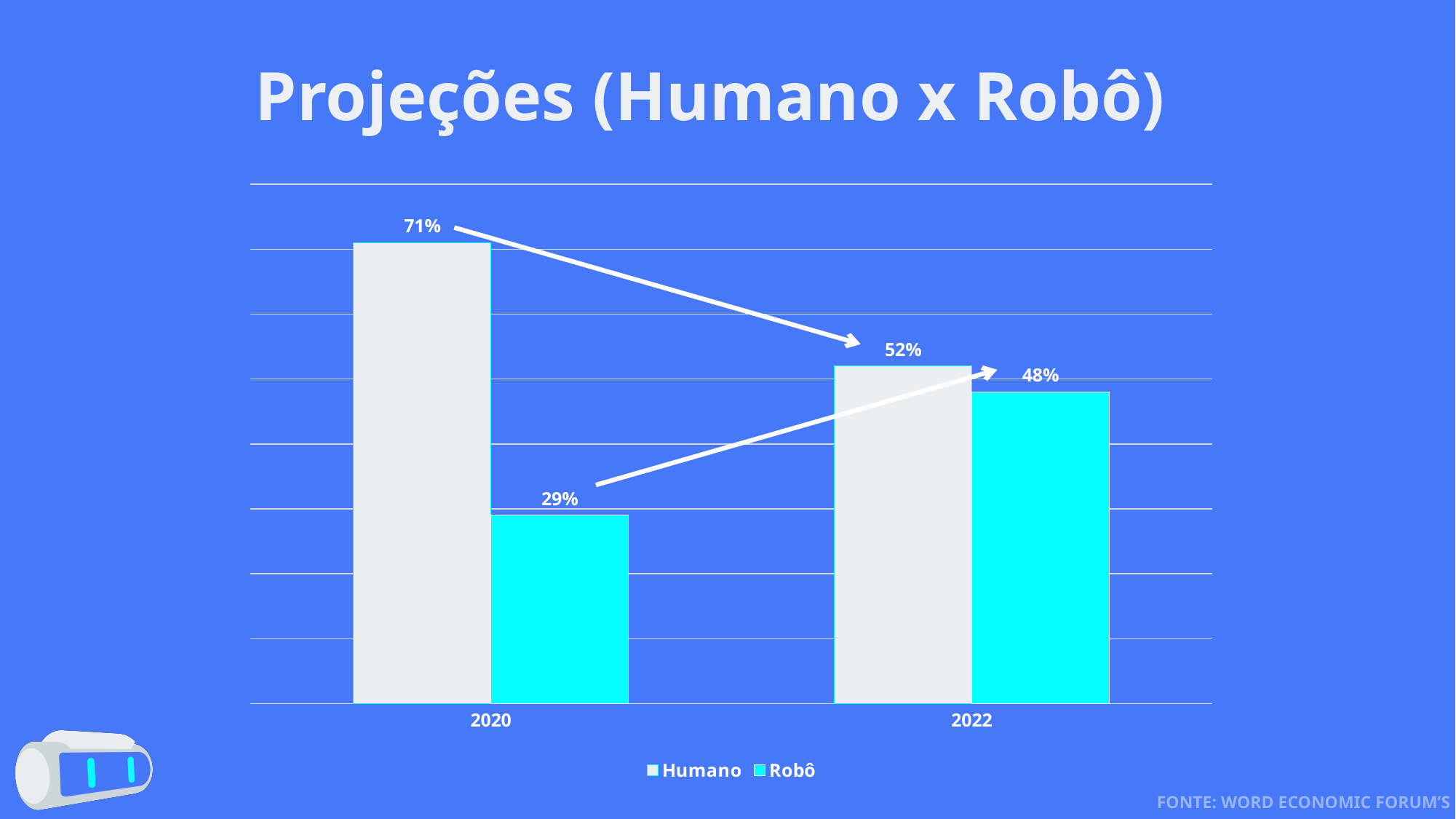
What is the value for Robô in 2020? 29% What is the value for Robô in 2022? 48% Does the Robô value rise or fall from 2020 to 2022? Rise Which is larger in 2022, Humano or Robô? Humano How many series does the legend list? 2 What is the difference between the Humano and Robô values in 2020? 42% What is the value for Humano in 2022? 52% What kind of chart is shown on the slide? Bar chart Which series has the highest value in 2020? Humano Which bar has the lowest value on the chart? Robô in 2020 What is the value for Humano in 2020? 71% By how much did the Humano value fall from 2020 to 2022? 19%